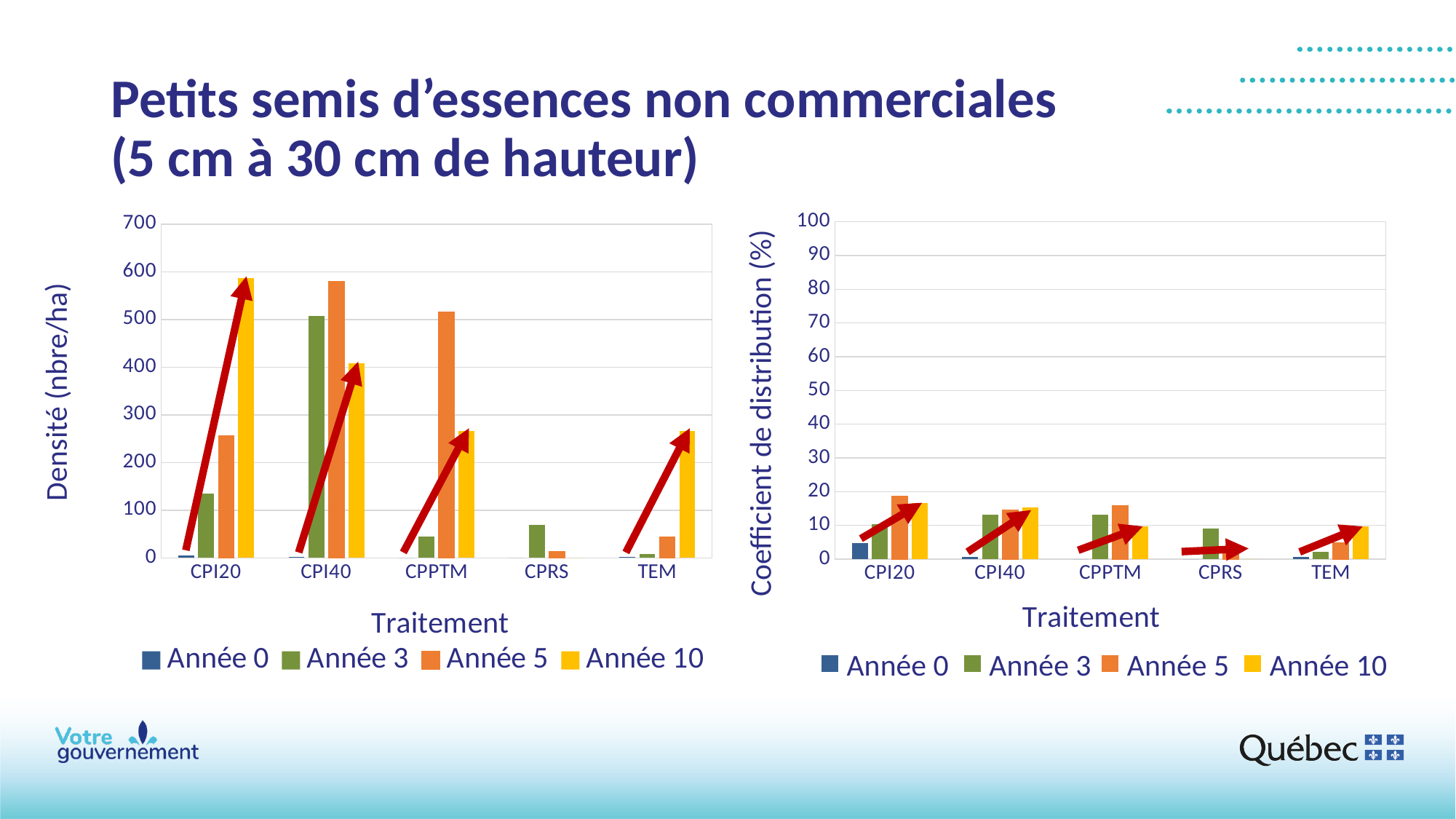
In the left chart (Densité), is the Année 3 value for CPRS greater or less than 100? less In the left chart (Densité), do the values for CPI20 rise or fall from Année 0 to Année 10? rise In the left chart (Densité), which treatment has the highest Année 10 bar? CPI20 What kind of chart is the left chart (Densité)? bar chart How many series does the legend of the left chart (Densité) list? 4 In the left chart (Densité), for CPI40, which is larger: the Année 3 value or the Année 10 value? Année 3 In the right chart (Coefficient de distribution), is the Année 5 value for CPI20 greater or less than 20? less In the right chart (Coefficient de distribution), for CPI20, which is larger: the Année 0 value or the Année 5 value? Année 5 How many treatments are shown on the x axis of the right chart (Coefficient de distribution)? 5 In the left chart (Densité), which treatment has the highest Année 5 bar? CPI40 What is the y-axis label of the right chart? Coefficient de distribution (%) In the left chart (Densité), is the Année 10 value for CPI20 greater or less than 500? greater